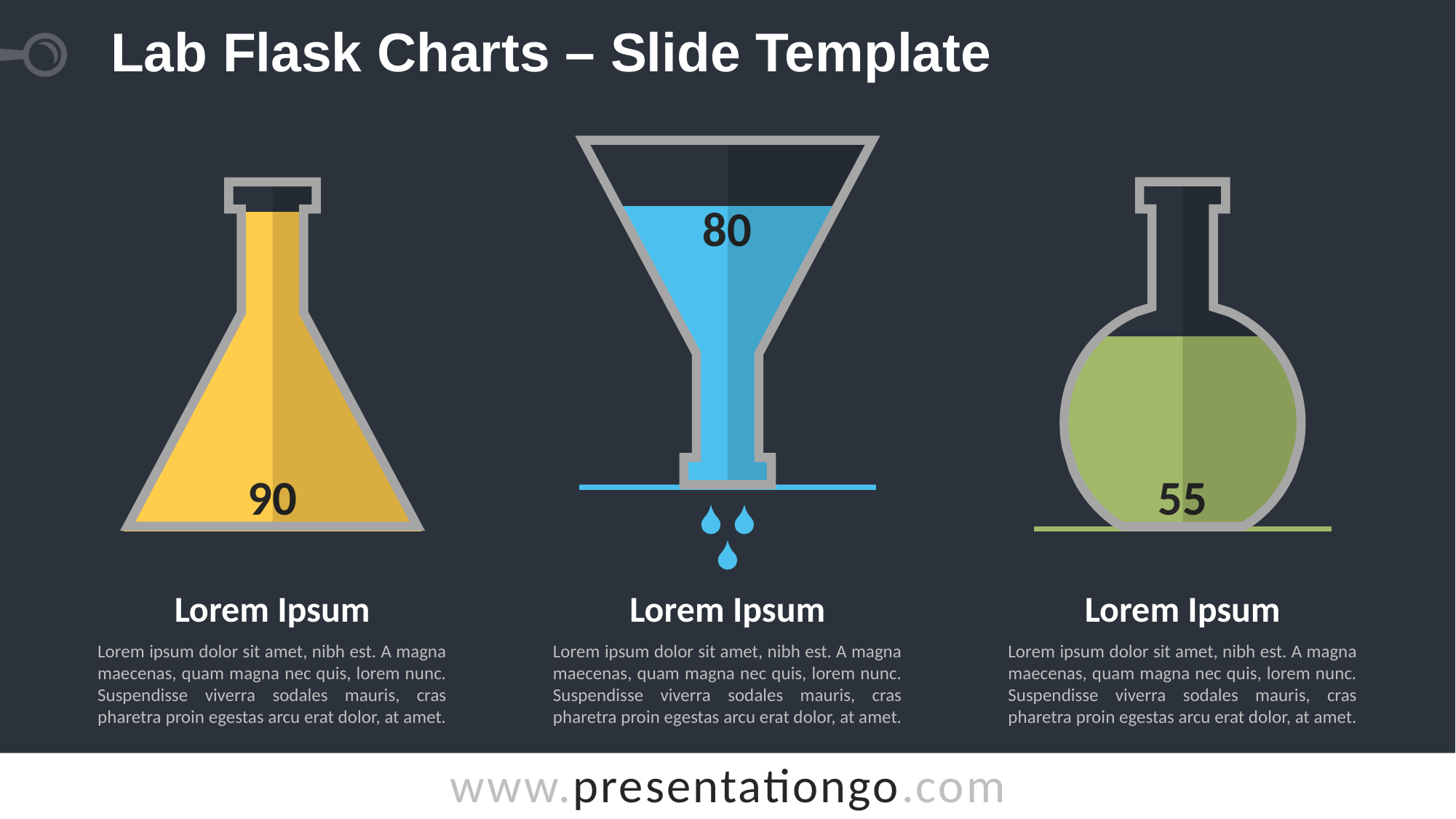
What value is printed on the middle (funnel) chart? 80 What value is printed on the right (round flask) chart? 55 Which of the three flask charts shows the lowest value? The right (round flask) chart, 55 How many flask charts are shown on the slide? 3 What is the difference between the value on the middle funnel chart and the value on the right flask chart? 25 What is the title of the slide? Lab Flask Charts – Slide Template What value is printed on the left (conical flask) chart? 90 What is the difference between the value on the left flask chart and the value on the right flask chart? 35 What is the total of the three values shown on the flask charts? 225 What colour is the liquid in the middle funnel chart? Blue Which is larger, the value on the left flask chart or the value on the middle funnel chart? The left flask chart (90) Which of the three flask charts shows the highest value? The left (conical flask) chart, 90